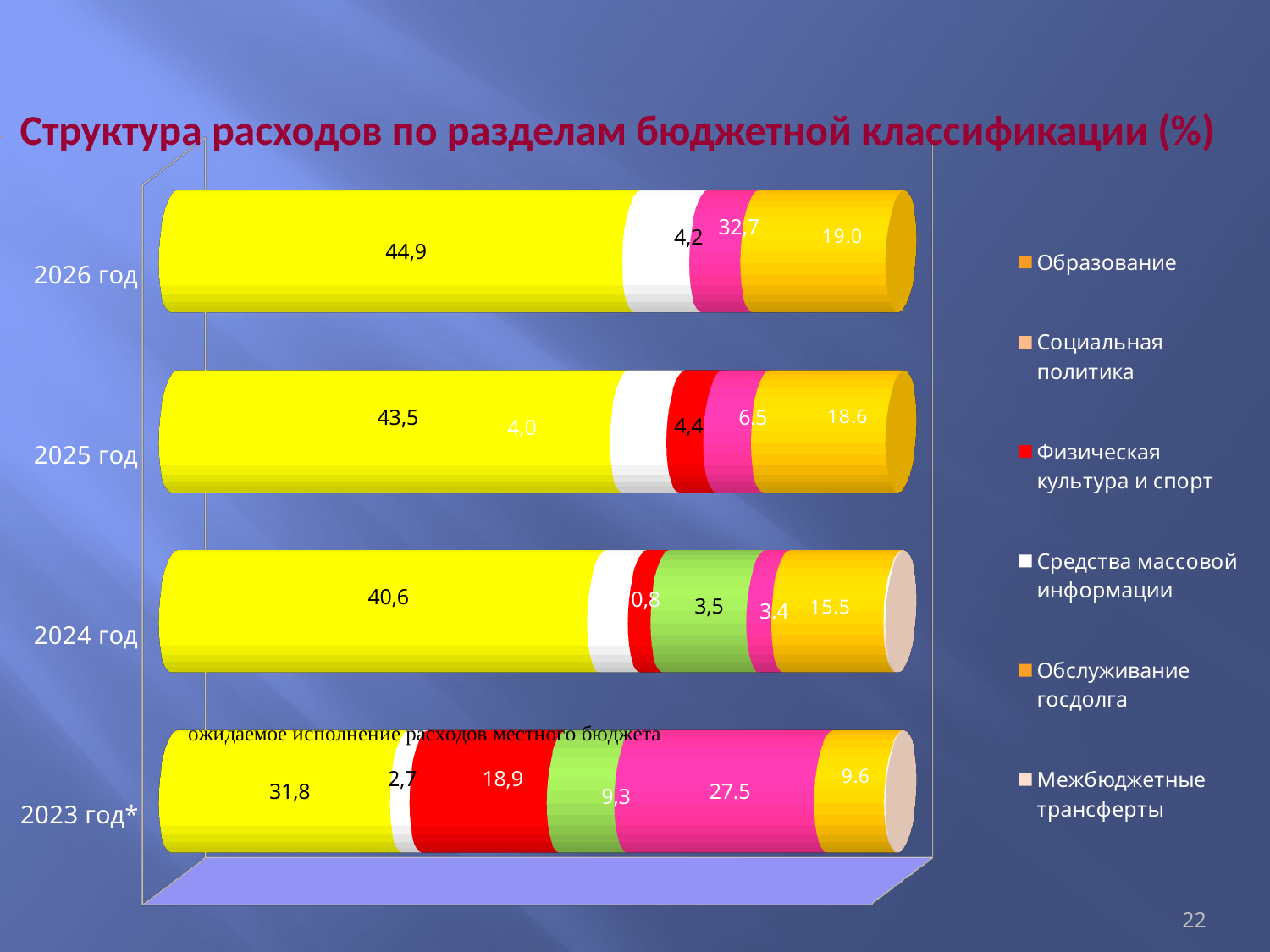
What is the value of the leftmost (yellow) segment of the bar for 2023 год*? 31,8 What is the value of the leftmost (yellow) segment of the bar for 2026 год? 44,9 What is the value of the red segment of the bar for 2023 год*? 18,9 What kind of chart is shown on the slide? Stacked bar chart What is the title of the chart? Структура расходов по разделам бюджетной классификации (%) How many year categories are plotted on the chart? 4 Which year has the largest leftmost (yellow) segment? 2026 год How many series does the legend list? 6 What is the value of the rightmost (gold) segment of the bar for 2024 год? 15.5 Which year has the smallest leftmost (yellow) segment? 2023 год* What is the value of the rightmost (gold) segment of the bar for 2025 год? 18.6 What is the difference between the leftmost (yellow) segment values for 2026 год and 2025 год? 1,4